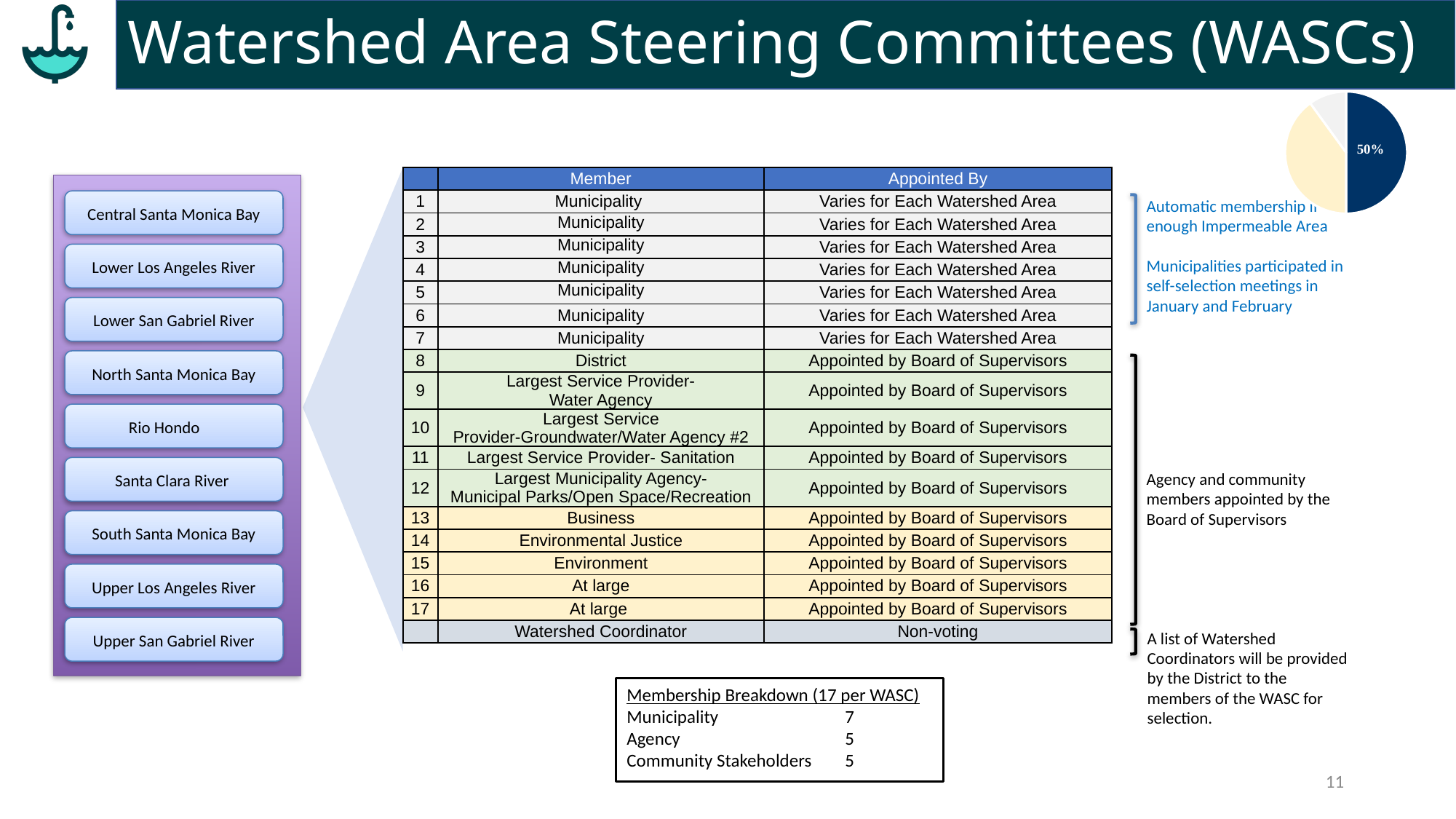
In the pie chart in the top right corner, which slice is the largest? the dark blue slice (50%) How many data labels are printed on the pie chart in the top right corner? 1 In the pie chart in the top right corner, what percentage is printed on the dark blue slice? 50% In the pie chart in the top right corner, which slice is the smallest? the light gray slice Does the pie chart in the top right corner show a legend? No What kind of chart is shown in the top right corner of the slide? pie chart In the pie chart in the top right corner, which is larger: the cream-coloured slice or the light gray slice? the cream-coloured slice How many slices does the pie chart in the top right corner have? 3